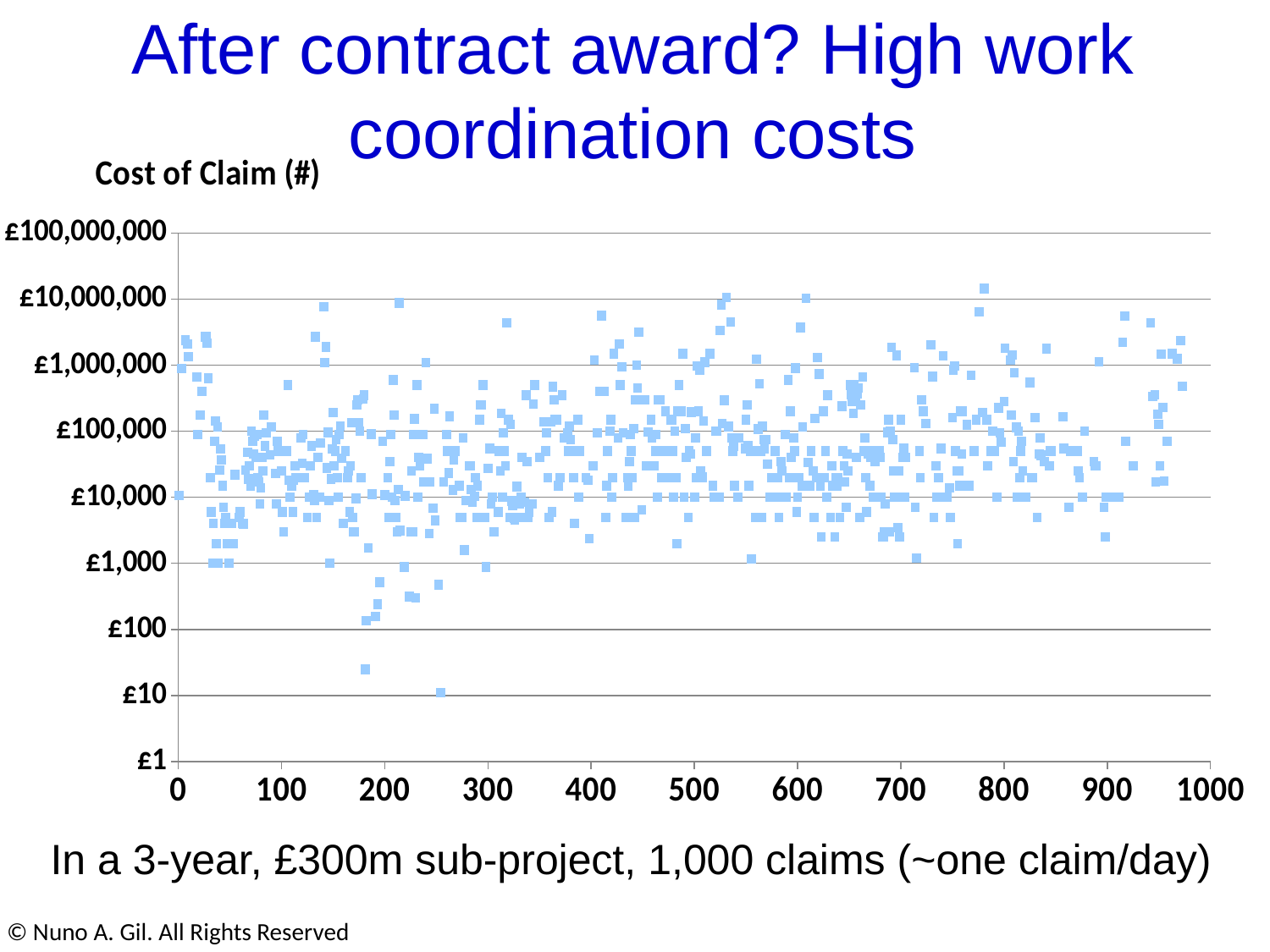
What is the highest value labelled on the vertical axis? £100,000,000 Is the highest plotted point, located near x = 780, greater or less than £1,000,000? greater What kind of chart is shown on the slide? scatter chart Is the lowest plotted point, located near x = 250, greater or less than £1,000? less Is the lowest plotted point on the chart greater or less than £100? less What is the title of the vertical axis of the chart? Cost of Claim (#)